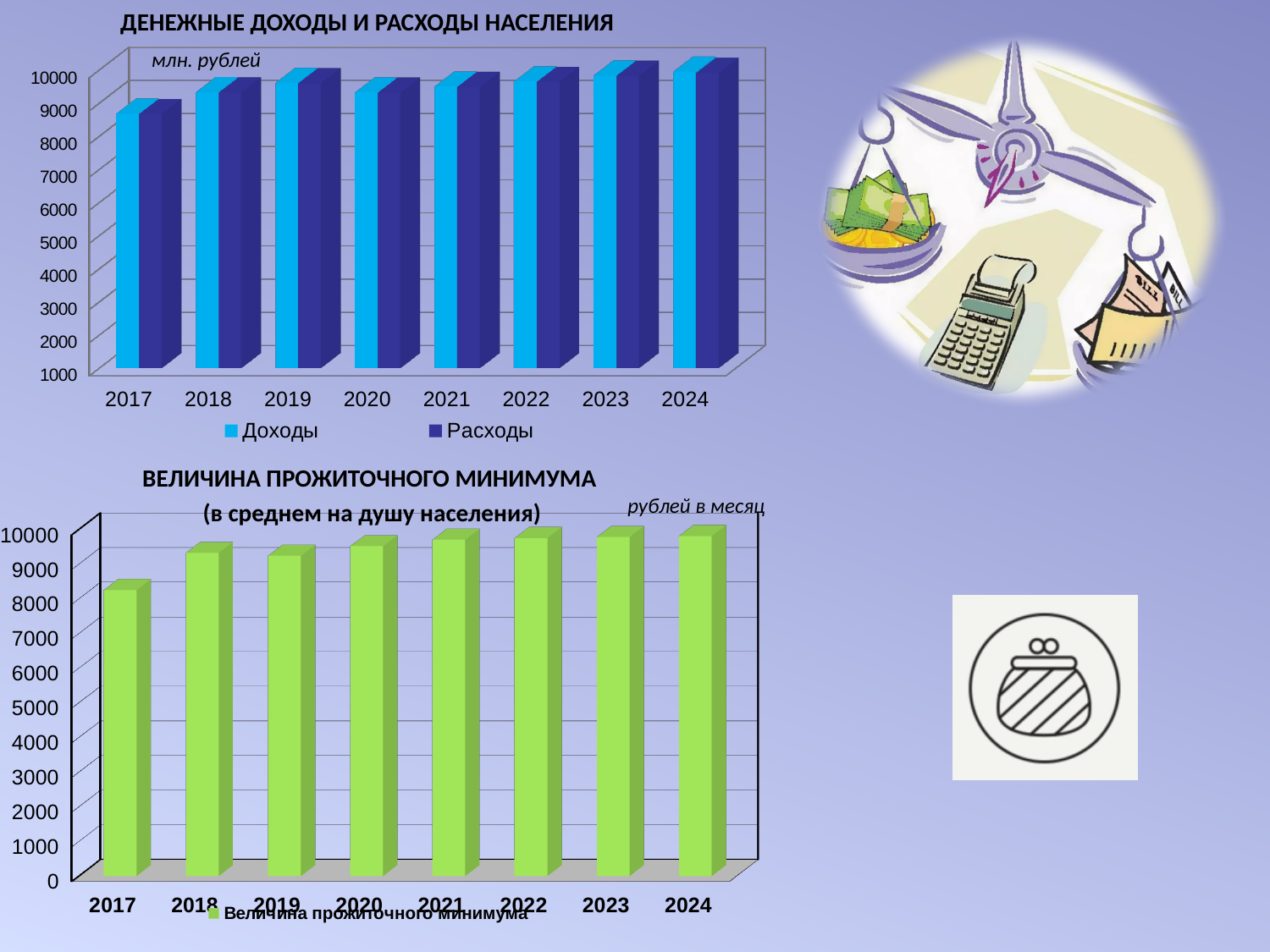
What kind of chart is the top chart titled 'ДЕНЕЖНЫЕ ДОХОДЫ И РАСХОДЫ НАСЕЛЕНИЯ'? Bar chart How many series does the legend of the top chart 'ДЕНЕЖНЫЕ ДОХОДЫ И РАСХОДЫ НАСЕЛЕНИЯ' list? 2 In the top chart 'ДЕНЕЖНЫЕ ДОХОДЫ И РАСХОДЫ НАСЕЛЕНИЯ', is the value for Доходы in 2020 greater or less than 9000? greater In the bottom chart 'ВЕЛИЧИНА ПРОЖИТОЧНОГО МИНИМУМА', do the values generally rise or fall from 2017 to 2024? rise In the bottom chart 'ВЕЛИЧИНА ПРОЖИТОЧНОГО МИНИМУМА', is the value for 2017 greater or less than 9000? less In the top chart 'ДЕНЕЖНЫЕ ДОХОДЫ И РАСХОДЫ НАСЕЛЕНИЯ', how many years are shown on the x axis? 8 How many series does the legend of the bottom chart 'ВЕЛИЧИНА ПРОЖИТОЧНОГО МИНИМУМА' list? 1 In the bottom chart 'ВЕЛИЧИНА ПРОЖИТОЧНОГО МИНИМУМА', is the value for 2024 greater or less than 9000? greater What unit is stated on the top chart 'ДЕНЕЖНЫЕ ДОХОДЫ И РАСХОДЫ НАСЕЛЕНИЯ'? млн. рублей In the bottom chart 'ВЕЛИЧИНА ПРОЖИТОЧНОГО МИНИМУМА', which year has the lowest value? 2017 In the top chart 'ДЕНЕЖНЫЕ ДОХОДЫ И РАСХОДЫ НАСЕЛЕНИЯ', which year has the lowest value for Доходы? 2017